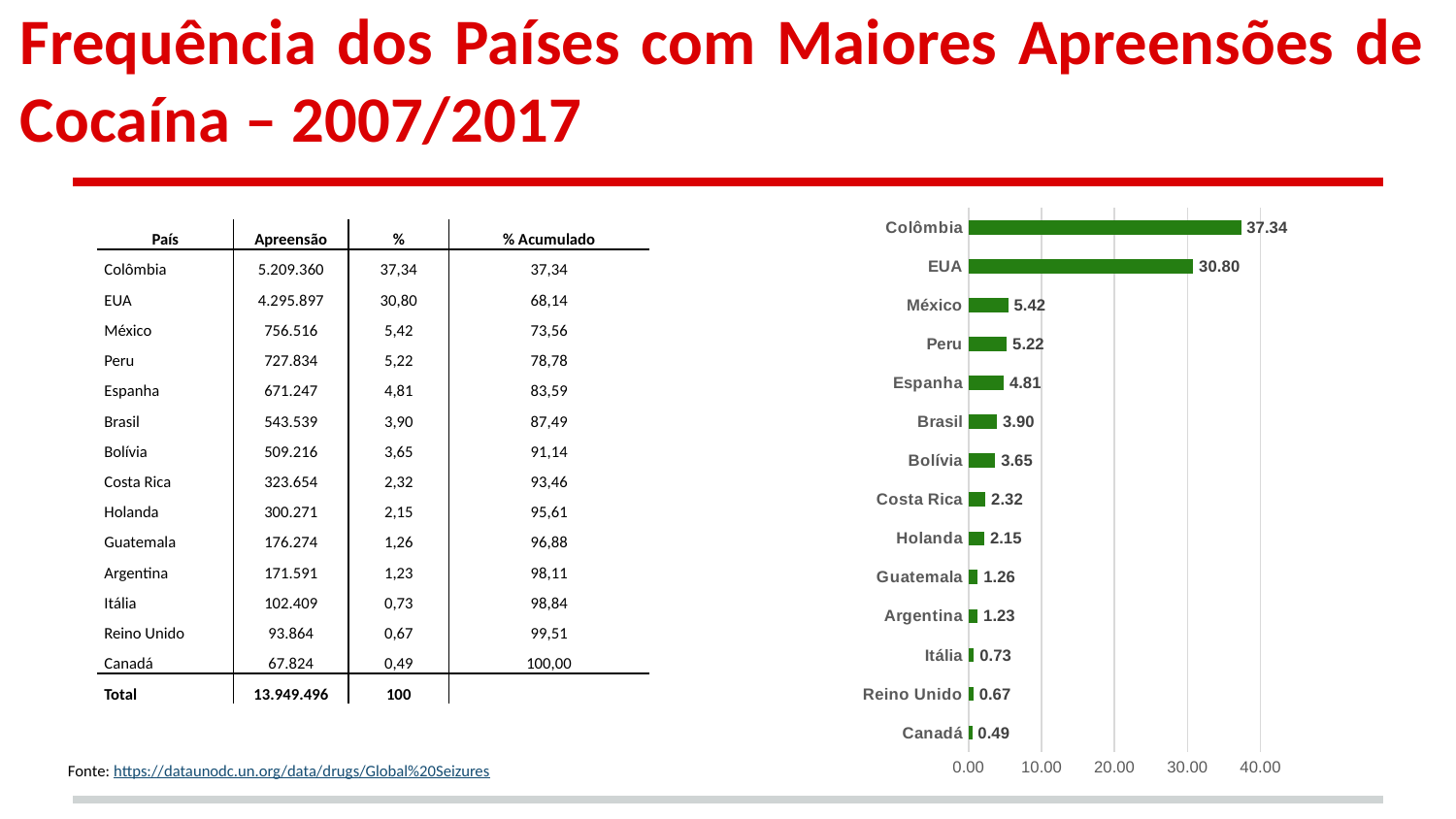
Which country has the highest value in the bar chart? Colômbia Which country has the lowest value in the bar chart? Canadá Is the value for Colômbia in the bar chart greater or less than 30.00? greater What is the value shown for Brasil in the bar chart? 3.90 What is the value shown for Reino Unido in the bar chart? 0.67 What is the difference between the values for Colômbia and EUA in the bar chart? 6.54 How many countries are shown in the bar chart? 14 What kind of chart is shown on the slide? bar chart Which has a larger value in the bar chart, México or Espanha? México What is the value shown for Colômbia in the bar chart? 37.34 What is the value shown for EUA in the bar chart? 30.80 What colour are the bars in the chart? green